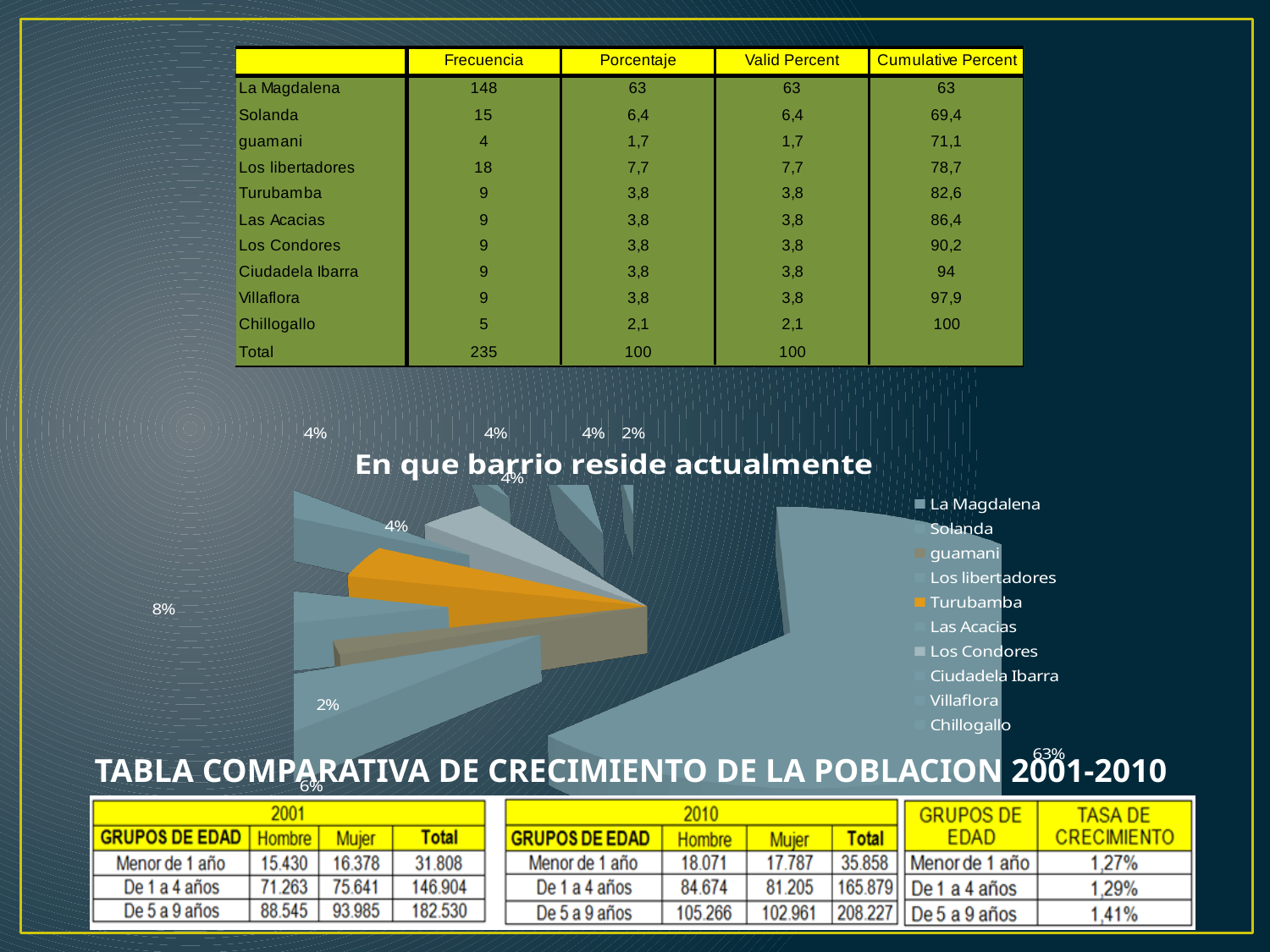
Which category is listed last in the legend of the pie chart? Chillogallo How many categories does the legend of the pie chart list? 10 In the pie chart, which is larger: the slice for La Magdalena or the slice for Solanda? La Magdalena Which category is listed first in the legend of the pie chart? La Magdalena What share of the pie chart does La Magdalena represent? 63% Which category has the largest slice in the pie chart? La Magdalena Which legend entry in the pie chart is shown in orange? Turubamba What kind of chart is shown under the title 'En que barrio reside actualmente'? pie chart